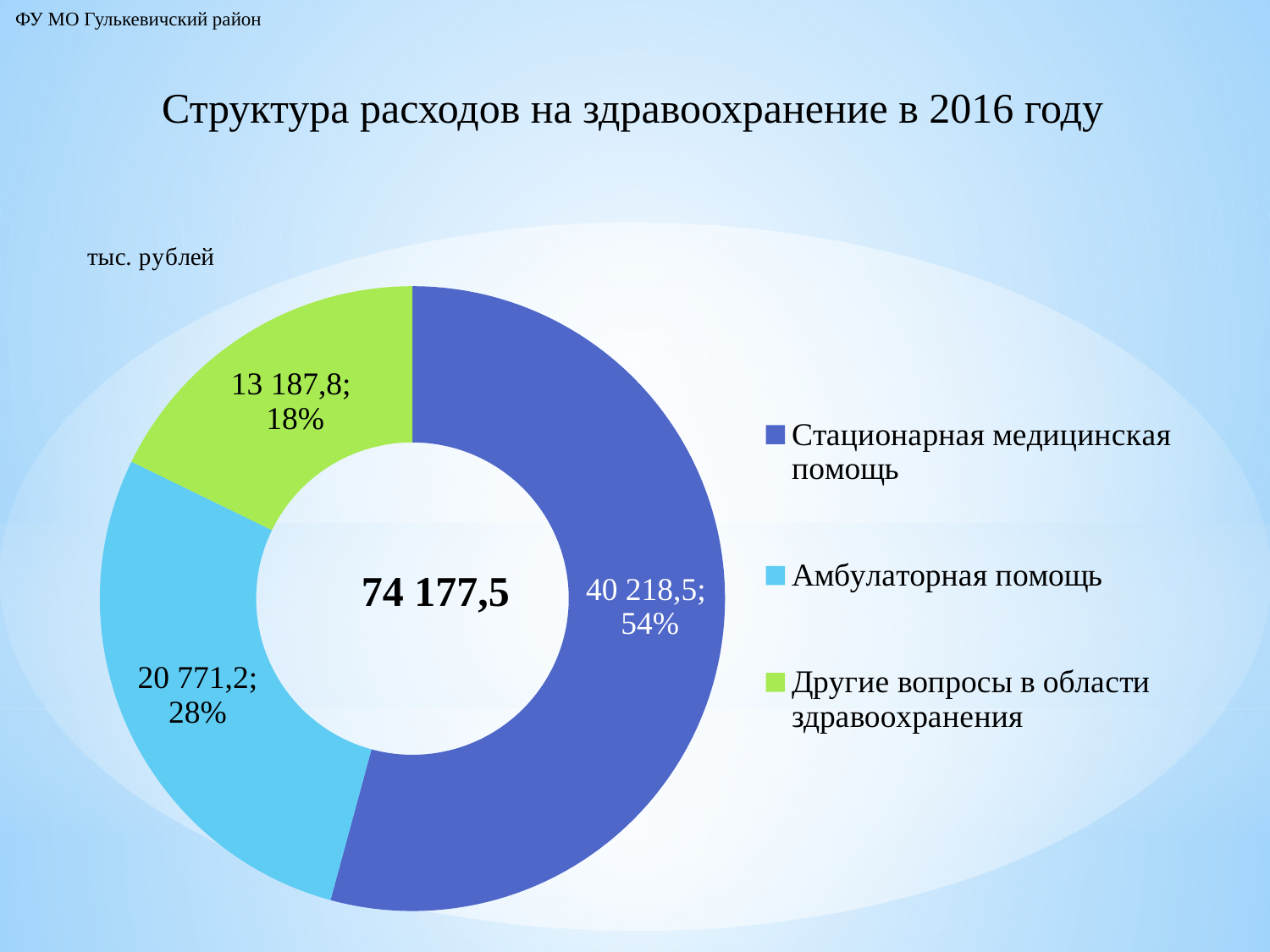
What share of the chart does Амбулаторная помощь represent? 28% How many categories are shown in the chart? 3 What kind of chart is shown on the slide? Doughnut (pie) chart What is the difference between the values for Стационарная медицинская помощь and Амбулаторная помощь? 19 447,3 Which category has the largest share of the chart? Стационарная медицинская помощь What share of the chart does Стационарная медицинская помощь represent? 54% What is the value for Амбулаторная помощь? 20 771,2 What is the value for Другие вопросы в области здравоохранения? 13 187,8 Which is larger: the value for Амбулаторная помощь or the value for Другие вопросы в области здравоохранения? Амбулаторная помощь What total value is shown in the centre of the chart? 74 177,5 What is the value for Стационарная медицинская помощь? 40 218,5 Which category has the smallest share of the chart? Другие вопросы в области здравоохранения